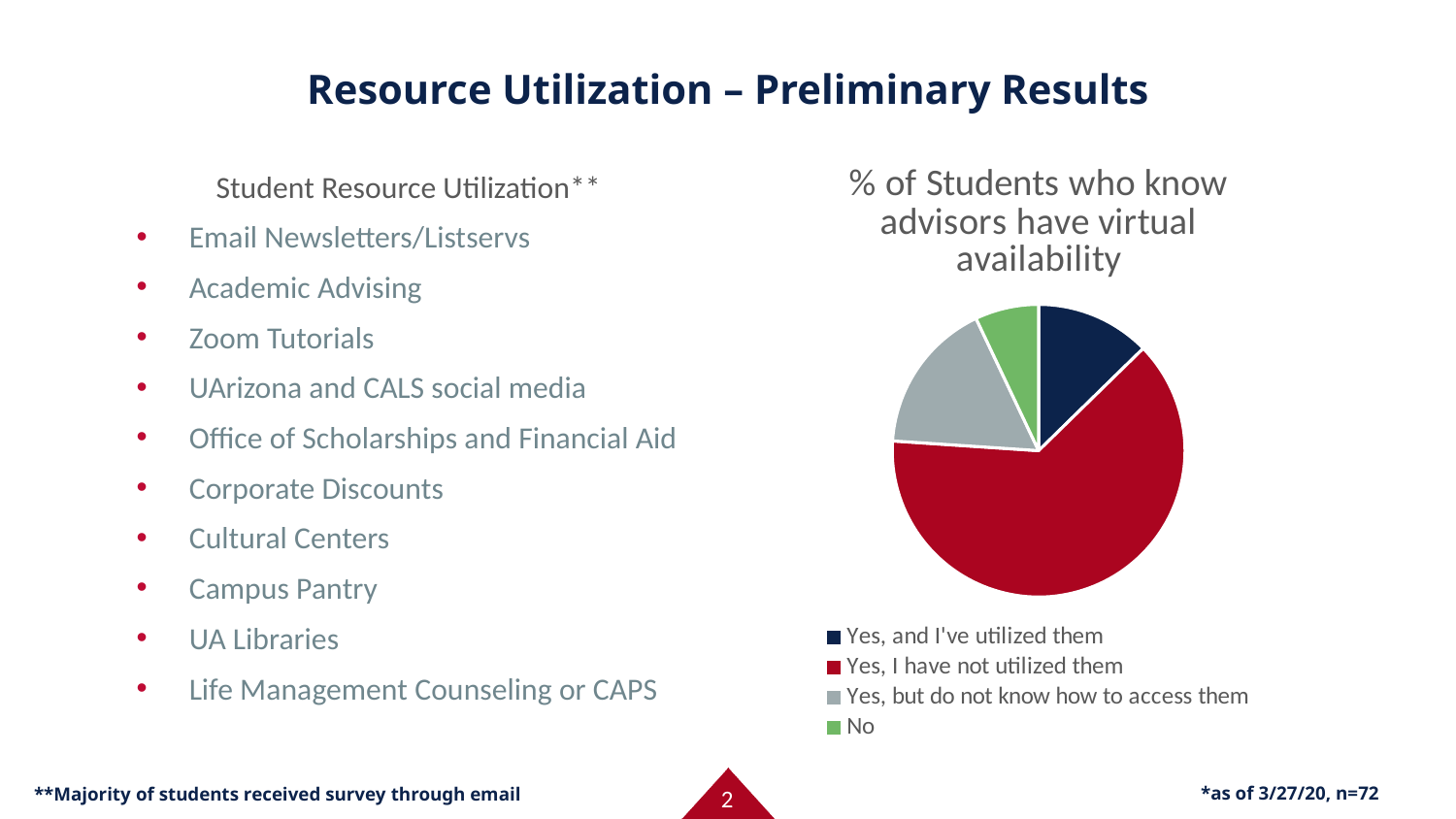
Which slice is larger: "Yes, and I've utilized them" or "No"? Yes, and I've utilized them What is the title of the pie chart? % of Students who know advisors have virtual availability What colour represents the "No" category in the pie chart? green Which slice is larger: "Yes, but do not know how to access them" or "Yes, and I've utilized them"? Yes, but do not know how to access them Which category has the smallest slice of the pie chart? No Which slice is larger: "Yes, but do not know how to access them" or "No"? Yes, but do not know how to access them How many slices does the pie chart have? 4 Which category has the largest slice of the pie chart? Yes, I have not utilized them What kind of chart is shown on the slide? pie chart How many entries does the pie chart's legend list? 4